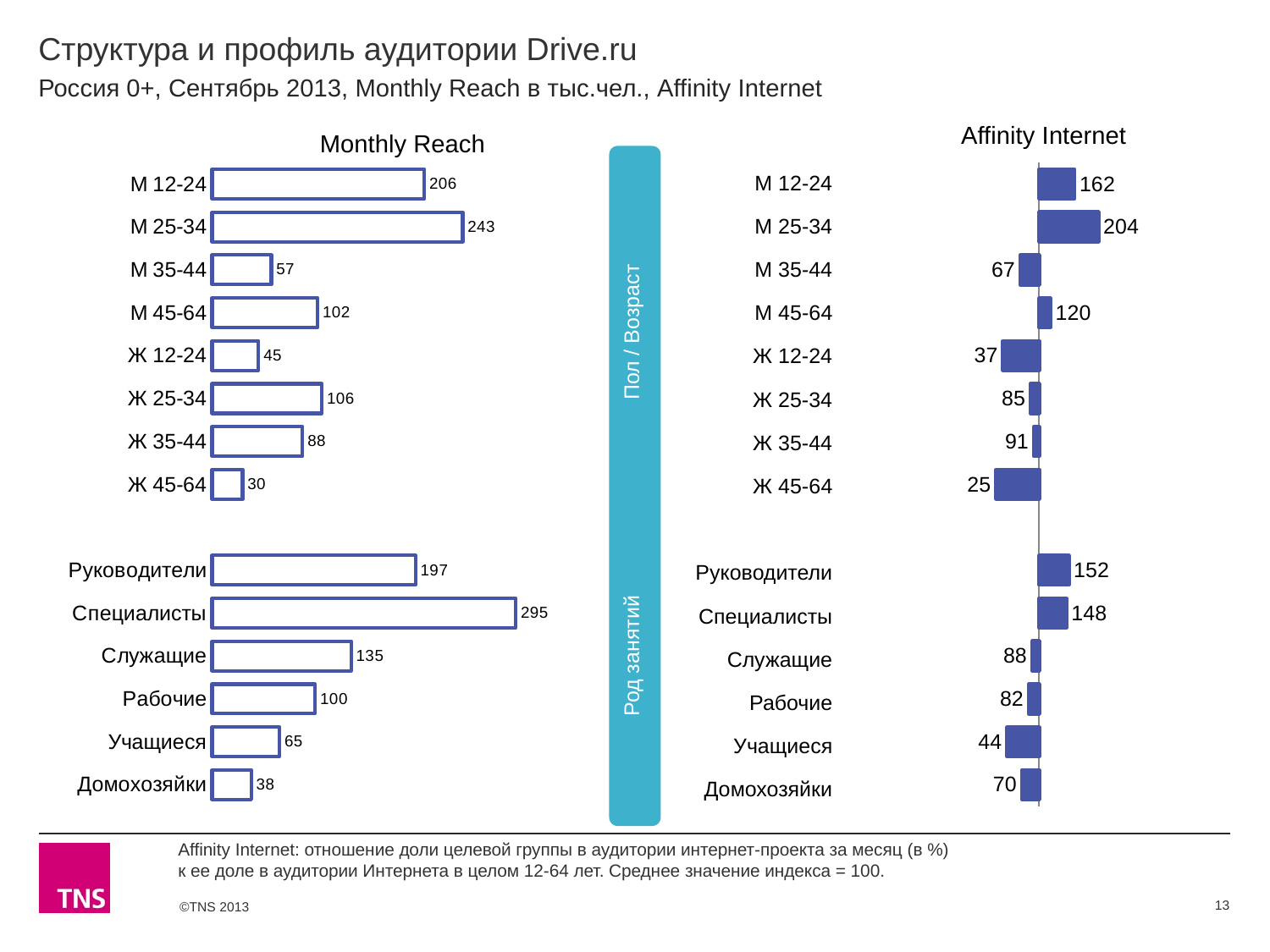
In the Monthly Reach chart, how many categories are plotted? 14 In the Monthly Reach chart, what is the value for Домохозяйки? 38 In the Affinity Internet chart, which is larger: the value for М 12-24 or the value for М 45-64? М 12-24 In the Affinity Internet chart, what is the difference between the values for М 25-34 and М 35-44? 137 In the Monthly Reach chart, which category has the highest value? Специалисты In the Monthly Reach chart, what is the difference between the values for Руководители and Служащие? 62 In the Affinity Internet chart, which category has the lowest value? Ж 45-64 What kind of chart is the Affinity Internet chart? Bar chart In the Monthly Reach chart, what is the value for М 25-34? 243 In the Affinity Internet chart, what is the value for Ж 45-64? 25 What is the title of the chart on the left side of the slide? Monthly Reach In the Affinity Internet chart, what is the value for Учащиеся? 44